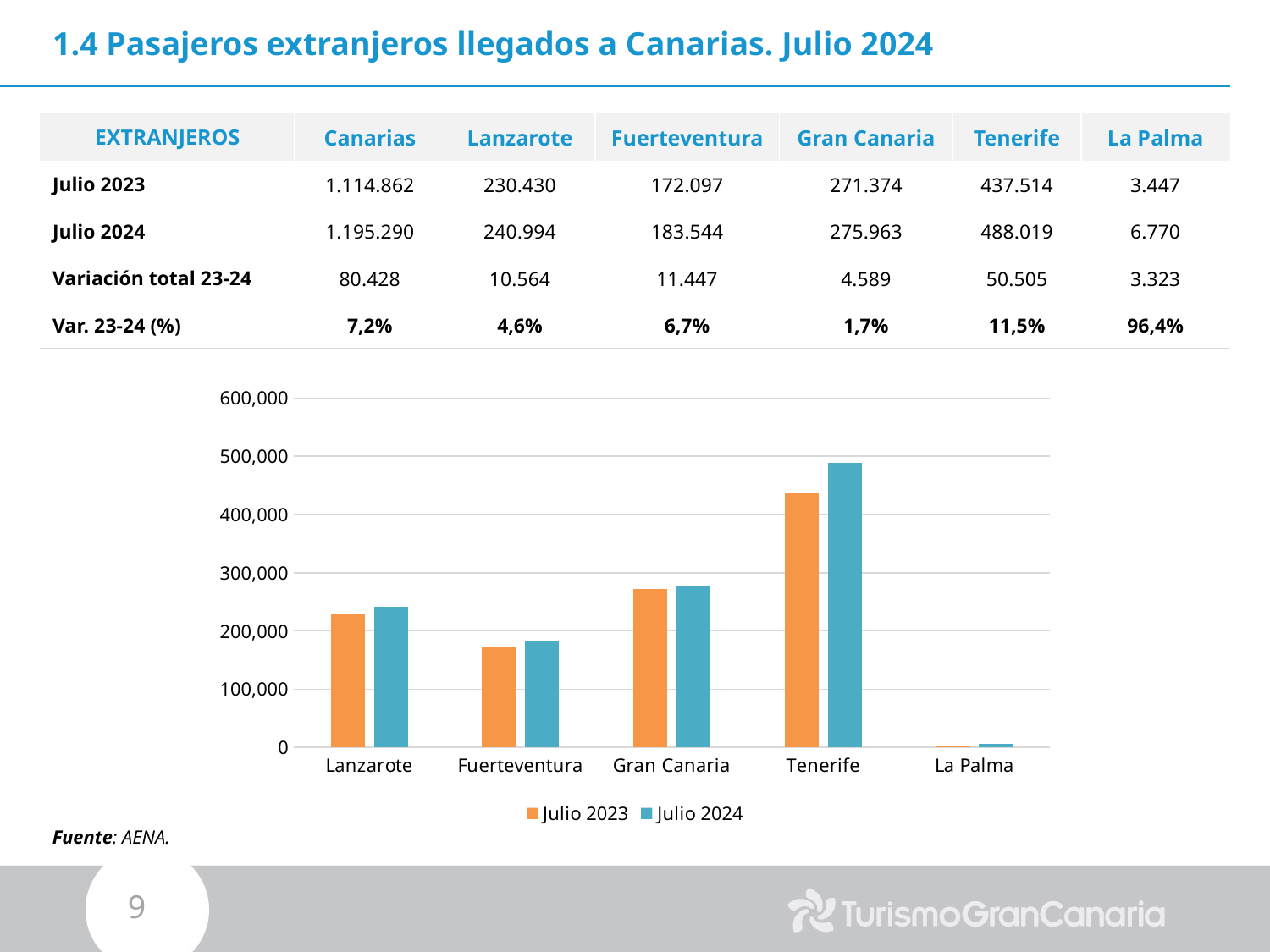
How many series does the chart legend list? 2 What is the number of foreign passengers arriving in Lanzarote in Julio 2023, as printed in the table? 230.430 Is the Julio 2023 value for Fuerteventura greater or less than 200,000? less Which colour represents the Julio 2023 series in the chart? orange Is the Julio 2024 value for Tenerife greater or less than 400,000? greater What is the number of foreign passengers arriving in Tenerife in Julio 2024, as printed in the table? 488.019 What is the difference between the Julio 2024 and Julio 2023 values for Fuerteventura? 11.447 Which island has the highest number of foreign passengers in Julio 2024? Tenerife How many island categories are shown on the x axis of the chart? 5 What kind of chart is shown on the slide? bar chart Which is larger for Gran Canaria: the Julio 2023 bar or the Julio 2024 bar? Julio 2024 Which island has the lowest number of foreign passengers in Julio 2023? La Palma